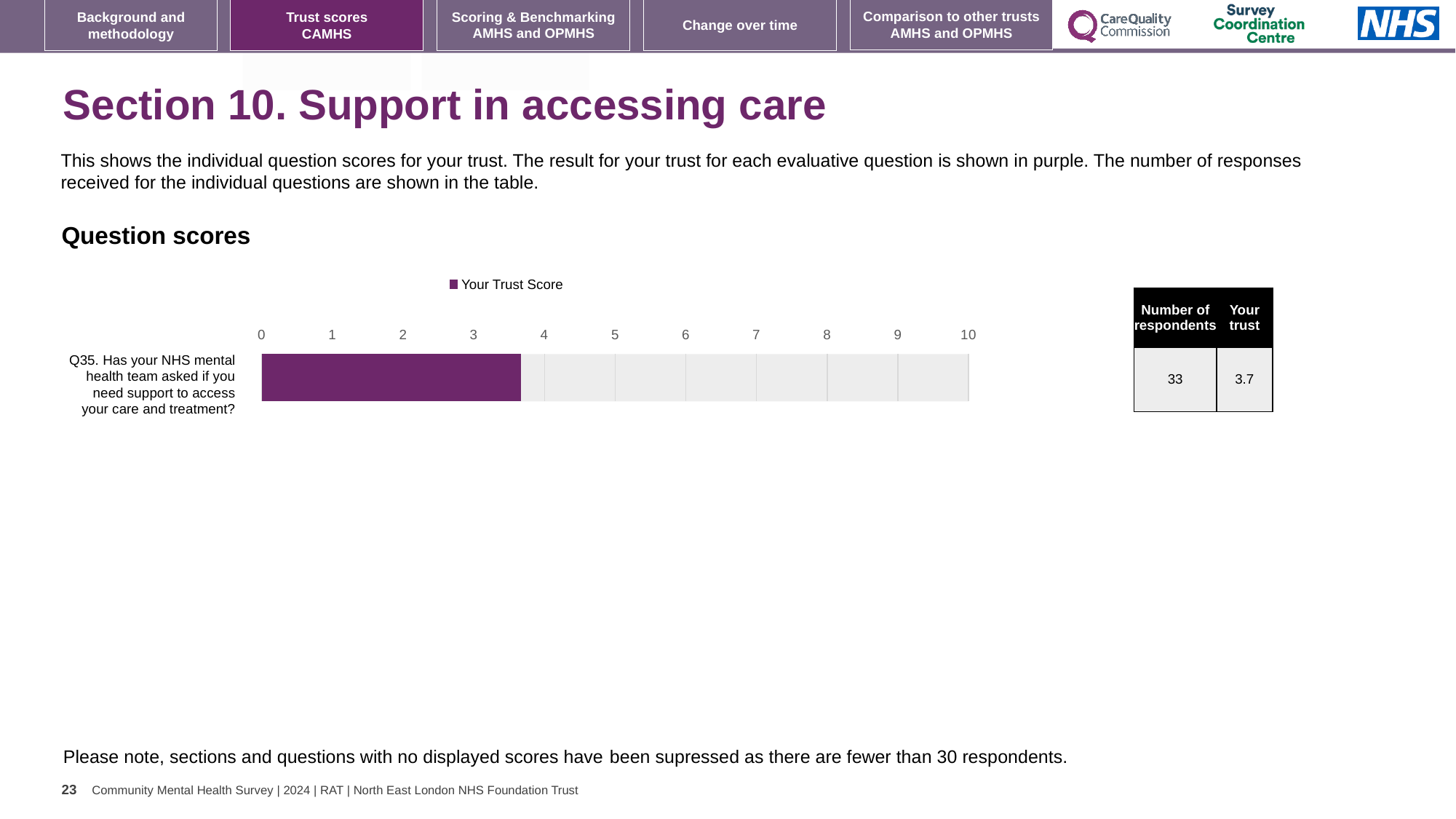
How many questions (bars) are plotted in the Question scores chart? 1 What type of chart is shown under 'Question scores'? bar chart Is the bar for Q35 in the Question scores chart greater or less than 3? greater How many series does the legend of the Question scores chart list? 1 What is the series name shown in the legend of the Question scores chart? Your Trust Score What is the maximum value shown on the x axis of the Question scores chart? 10 How many respondents answered Q35 according to the table next to the chart? 33 Is the bar for Q35 in the Question scores chart greater or less than 5? less What is the trust score for Q35 (Has your NHS mental team asked if you need support to access your care and treatment?) as shown in the table? 3.7 Which question is plotted in the Question scores chart? Q35. Has your NHS mental health team asked if you need support to access your care and treatment?